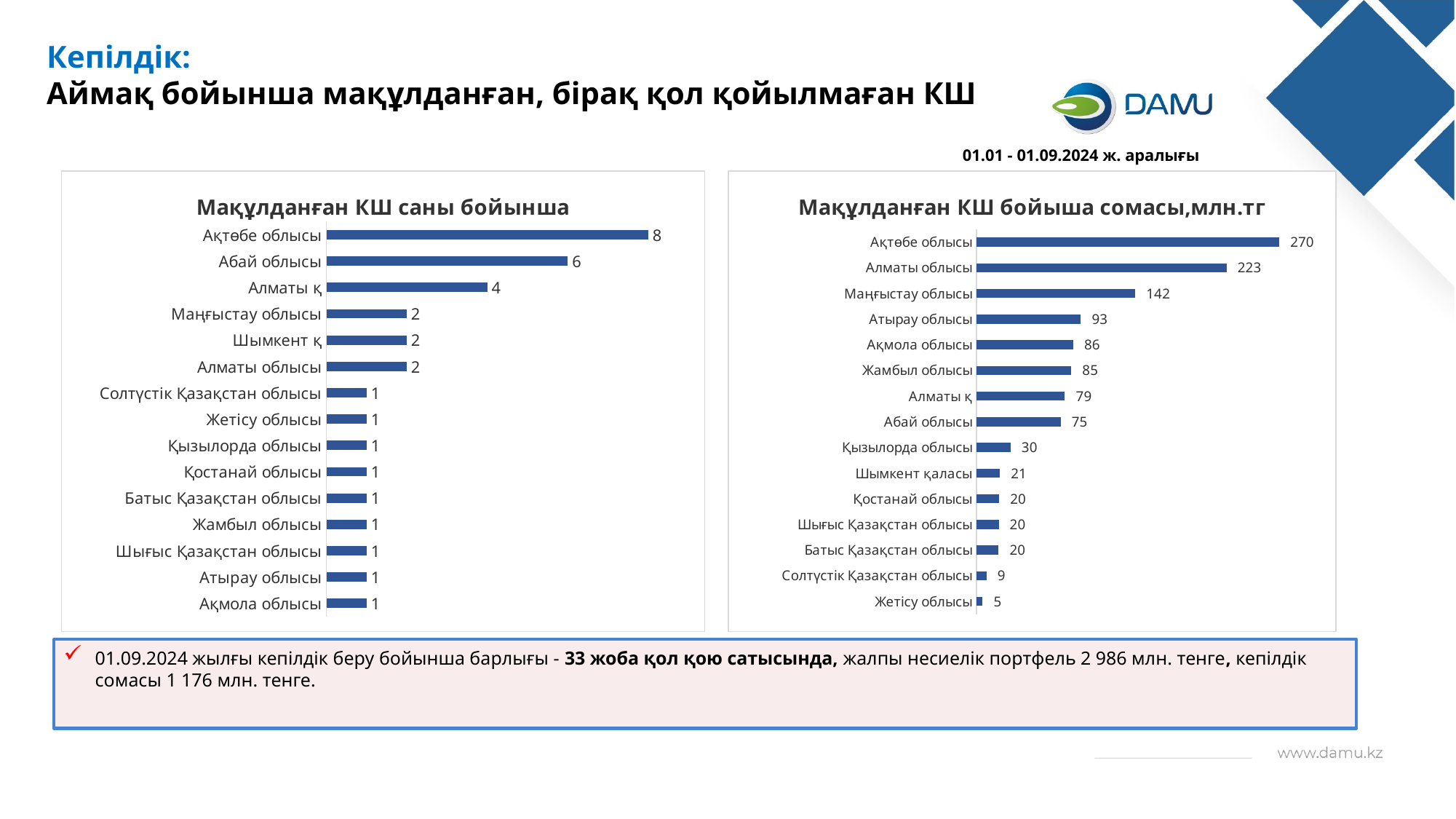
What is the title of the chart on the right side of the slide? Мақұлданған КШ бойыша сомасы,млн.тг In the chart 'Мақұлданған КШ саны бойынша', what is the value for Абай облысы? 6 In the chart 'Мақұлданған КШ саны бойынша', what is the value for Шымкент қ? 2 What type of chart is 'Мақұлданған КШ бойыша сомасы,млн.тг'? Bar chart In the chart 'Мақұлданған КШ бойыша сомасы,млн.тг', which is larger: Атырау облысы or Ақмола облысы? Атырау облысы In the chart 'Мақұлданған КШ бойыша сомасы,млн.тг', what is the difference between Ақтөбе облысы and Алматы облысы? 47 In the chart 'Мақұлданған КШ бойыша сомасы,млн.тг', which region has the lowest value? Жетісу облысы In the chart 'Мақұлданған КШ саны бойынша', how many categories are shown? 15 In the chart 'Мақұлданған КШ саны бойынша', what is the difference between Ақтөбе облысы and Алматы қ? 4 In the chart 'Мақұлданған КШ бойыша сомасы,млн.тг', what is the value for Маңғыстау облысы? 142 In the chart 'Мақұлданған КШ саны бойынша', which region has the highest value? Ақтөбе облысы In the chart 'Мақұлданған КШ бойыша сомасы,млн.тг', what is the value for Солтүстік Қазақстан облысы? 9